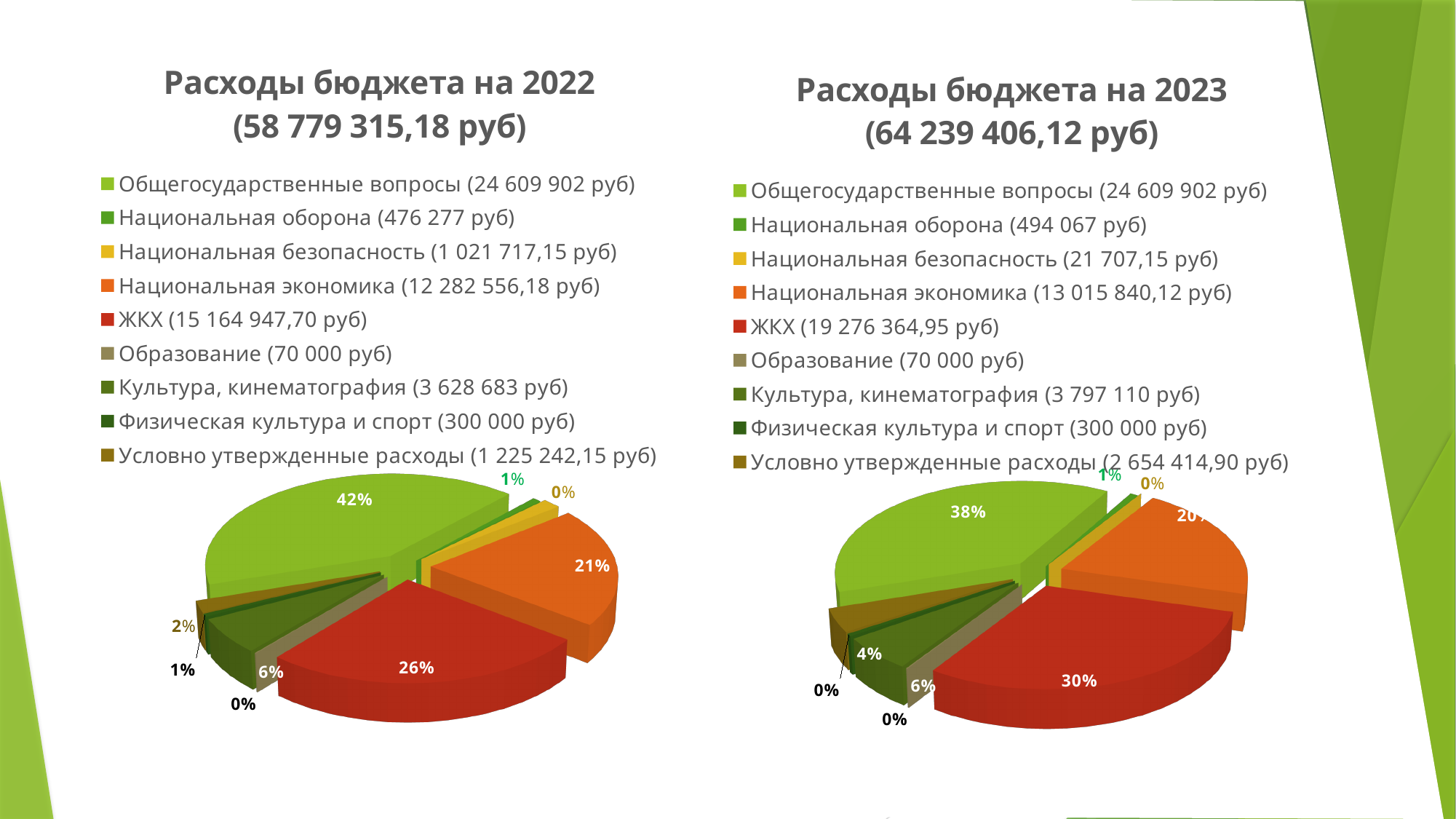
What kind of chart is used on the left side of the slide for 'Расходы бюджета на 2022'? Pie chart In the 'Расходы бюджета на 2023' chart, what amount does the legend give for ЖКХ? 19 276 364,95 руб In the 'Расходы бюджета на 2022' chart, what amount does the legend give for Национальная экономика? 12 282 556,18 руб In the 'Расходы бюджета на 2022' chart, what is the difference in percentage points between the Общегосударственные вопросы slice and the ЖКХ slice? 16 percentage points What total budget amount is shown in the title of the right-hand chart for 2023? 64 239 406,12 руб In the 'Расходы бюджета на 2023' chart, what percentage is shown for ЖКХ? 30% In the 'Расходы бюджета на 2022' chart, which category has the largest slice? Общегосударственные вопросы Which is larger: the ЖКХ share in the 2022 chart or the ЖКХ share in the 2023 chart? 2023 (30%) In the 'Расходы бюджета на 2022' chart, what share of the pie is labelled for Общегосударственные вопросы? 42% In the 'Расходы бюджета на 2022' chart, how many categories does the legend list? 9 In the 'Расходы бюджета на 2022' chart, what percentage is shown for ЖКХ? 26% In the 'Расходы бюджета на 2023' chart, what share of the pie is labelled for Общегосударственные вопросы? 38%